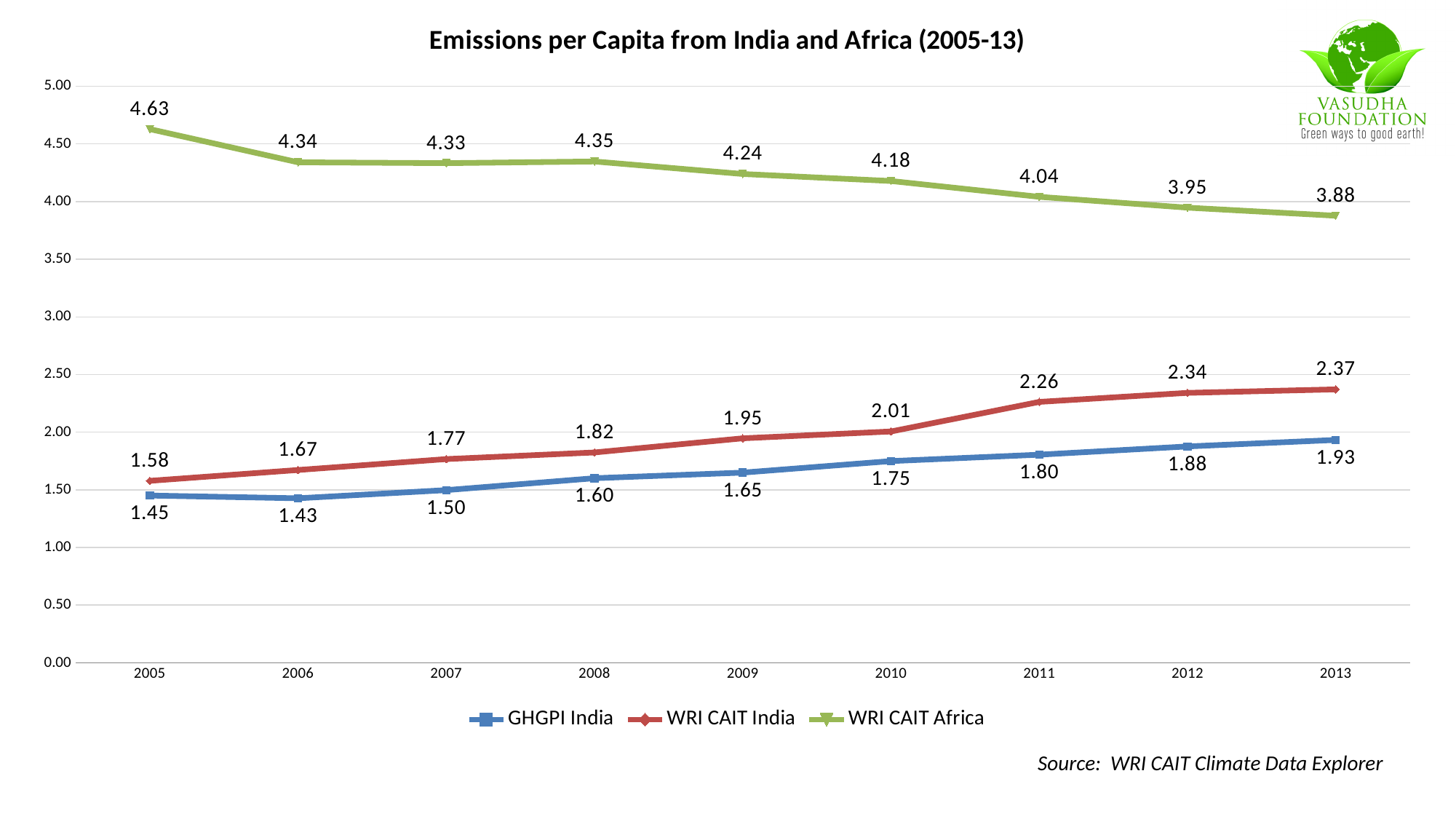
In which year is the WRI CAIT Africa series at its highest? 2005 What kind of chart is shown on the slide? Line chart In which year is the GHGPI India series at its lowest? 2006 How many series does the legend list? 3 Does the WRI CAIT Africa series rise or fall from 2005 to 2013? Fall What is the WRI CAIT Africa value for 2005? 4.63 What is the WRI CAIT India value for 2013? 2.37 How many years are shown on the x axis? 9 Which is larger in 2008: the WRI CAIT Africa value or the WRI CAIT India value? WRI CAIT Africa What is the difference between the WRI CAIT India and GHGPI India values in 2013? 0.44 What is the title of the chart? Emissions per Capita from India and Africa (2005-13) What is the GHGPI India value for 2010? 1.75